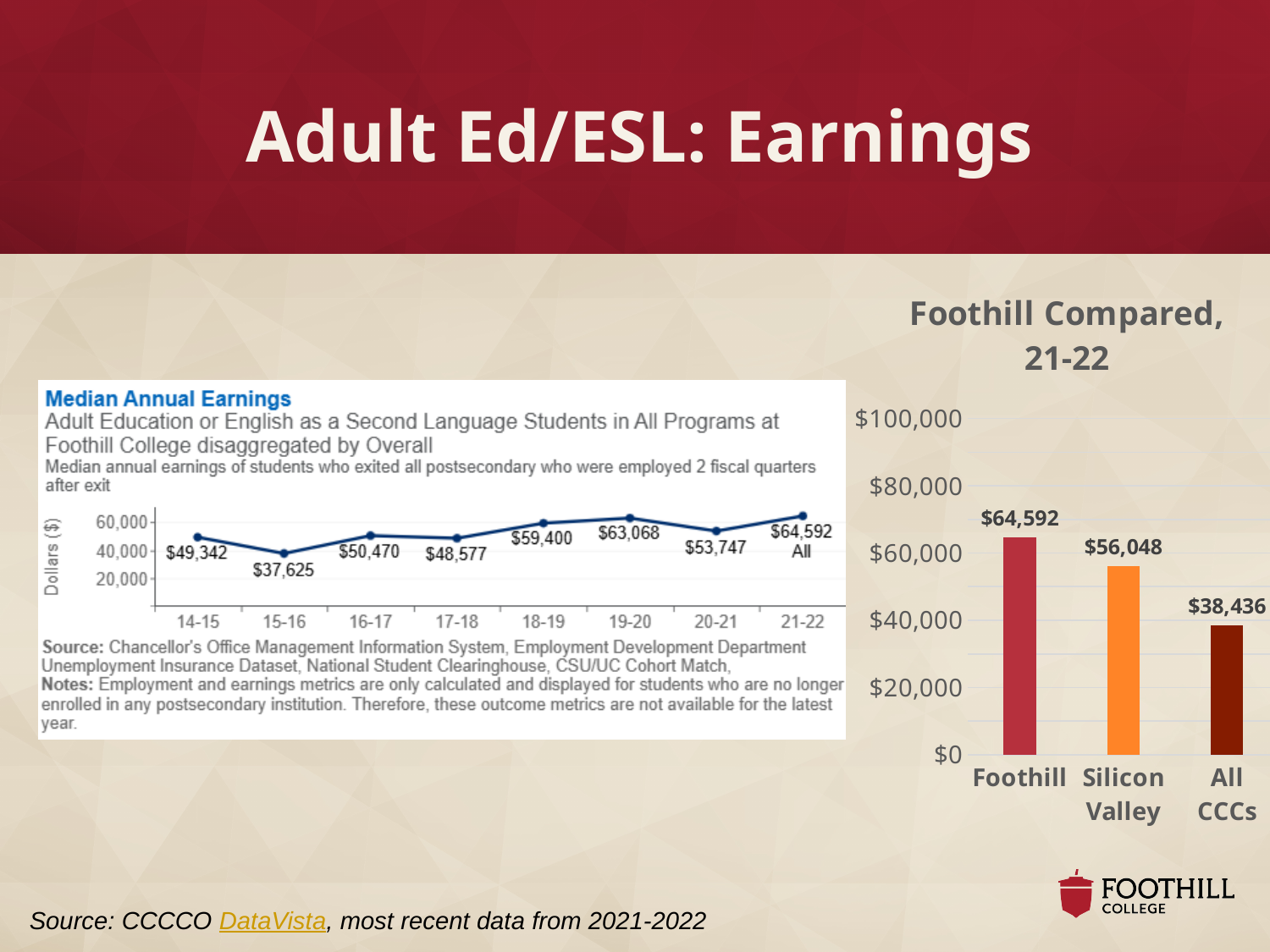
In the Median Annual Earnings line chart on the left, is the value for 18-19 larger than the value for 20-21? Yes In the Median Annual Earnings line chart on the left, which year has the highest median annual earnings? 21-22 In the Median Annual Earnings line chart on the left, what is the difference between the 21-22 value and the 14-15 value? $15,250 In the Foothill Compared, 21-22 chart on the right, which category has the lowest value? All CCCs In the Median Annual Earnings line chart on the left, which year has the lowest median annual earnings? 15-16 In the Median Annual Earnings line chart on the left, what is the value for 19-20? $63,068 In the Foothill Compared, 21-22 chart on the right, what is the value for Silicon Valley? $56,048 In the Median Annual Earnings line chart on the left, how many years are plotted? 8 What kind of chart is the Foothill Compared, 21-22 chart on the right? Bar chart What kind of chart is the Median Annual Earnings chart on the left? Line chart In the Median Annual Earnings line chart on the left, what is the value for 15-16? $37,625 In the Foothill Compared, 21-22 chart on the right, what is the difference between Foothill and All CCCs? $26,156